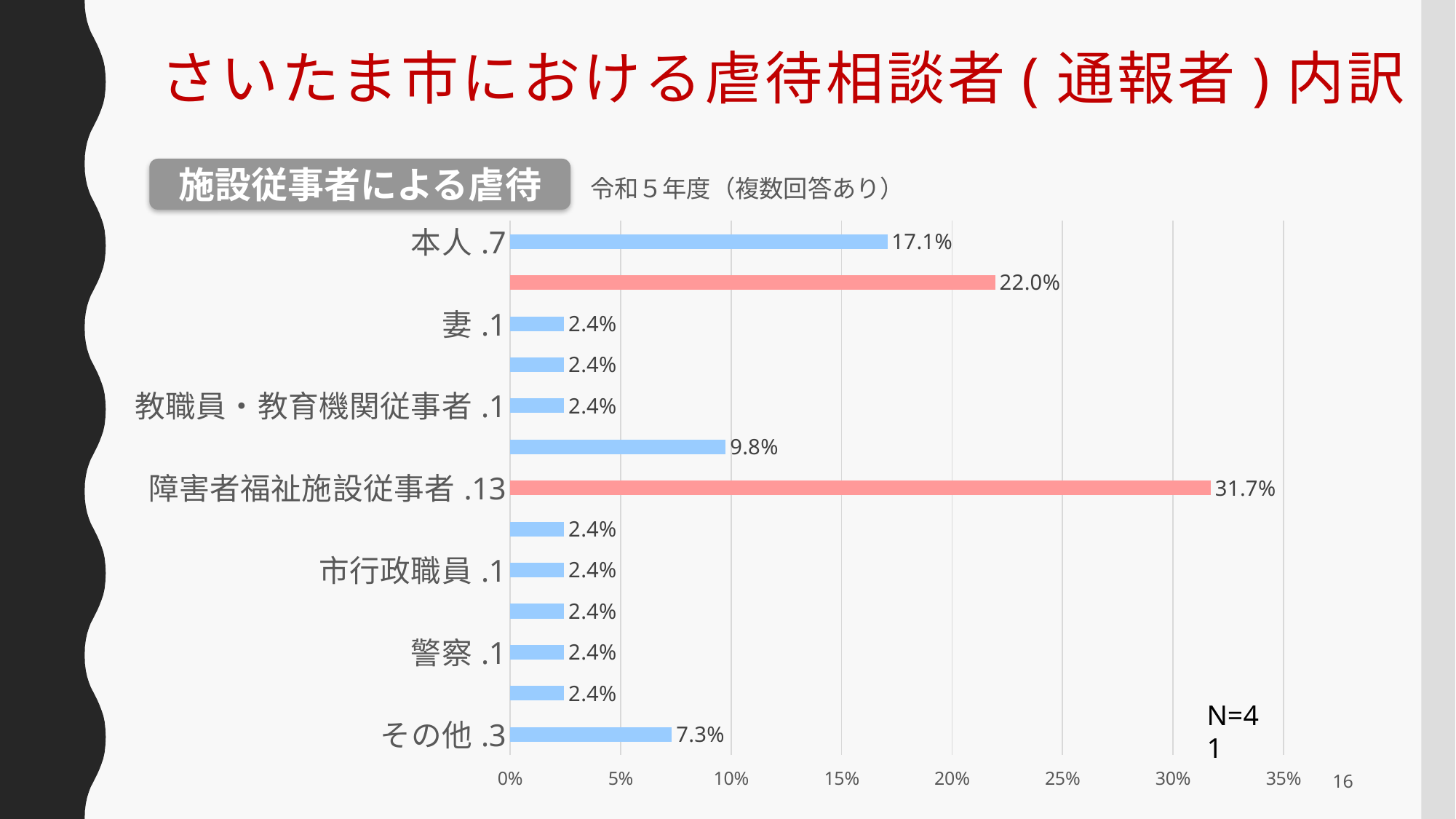
What is the value for 本人 in the chart? 17.1% What kind of chart is shown on the slide? bar chart What is the value for 障害者福祉施設従事者 in the chart? 31.7% What sample size (N) is shown on the chart? N=41 What is the value for その他 in the chart? 7.3% What is the difference between the values for 障害者福祉施設従事者 and 本人? 14.6% What is the value for 妻 in the chart? 2.4% Which is larger, the value for 本人 or the value for その他? 本人 What is the difference between the values for 本人 and その他? 9.8% How many bars are plotted in the chart? 13 Which category has the highest value in the chart? 障害者福祉施設従事者 Is the value for 障害者福祉施設従事者 greater or less than 30%? greater